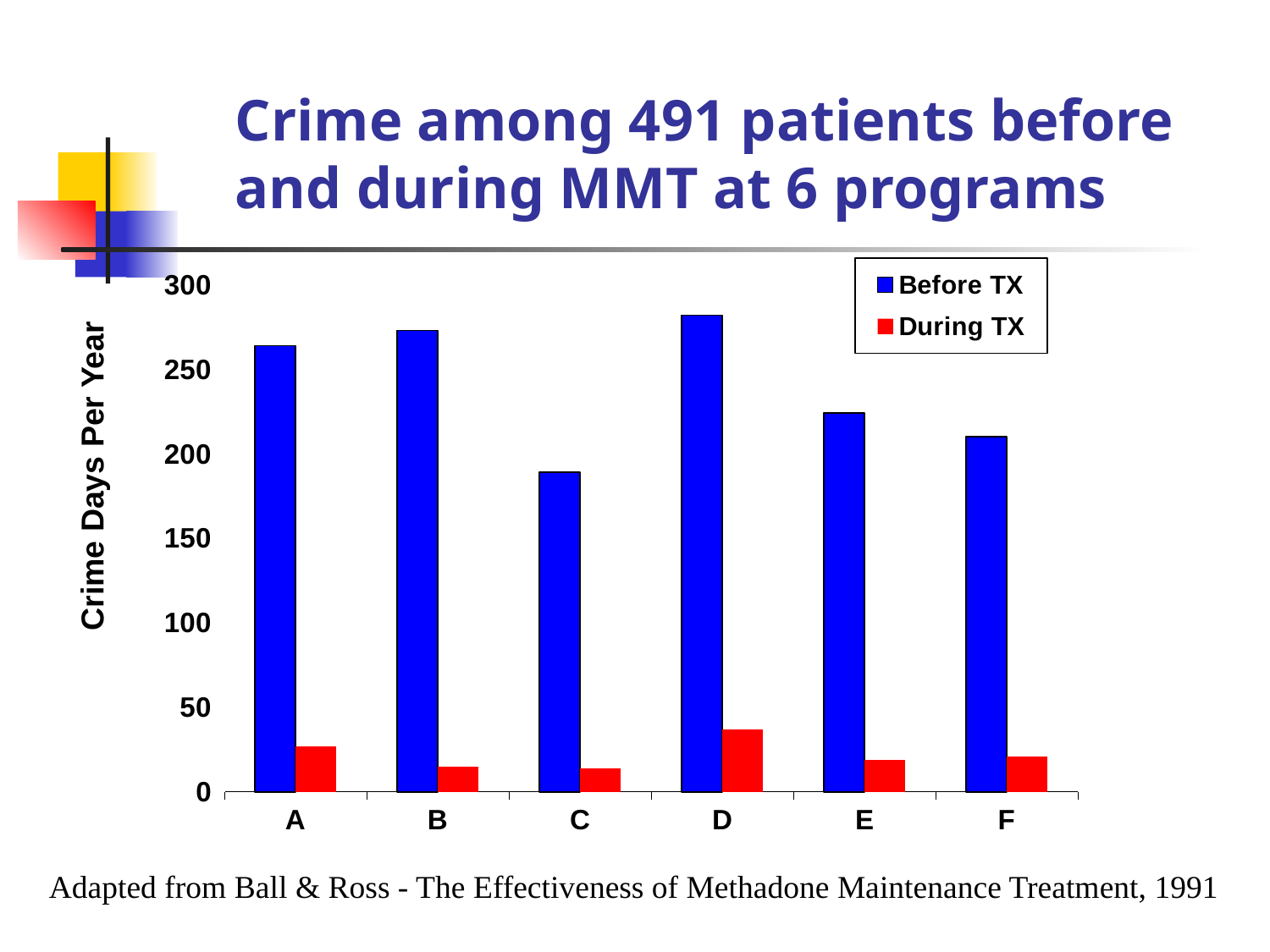
How many series does the legend list? 2 Which is larger, the During TX value for program D or for program B? D How many programs (categories) are shown on the x axis? 6 What kind of chart is shown on the slide? bar chart What is the label of the y axis? Crime Days Per Year Is the Before TX value for program A greater or less than 250? greater Is the During TX value for program D greater or less than 50? less Which program has the highest During TX value? D Is the Before TX value for program C greater or less than 200? less Which program has the lowest Before TX value? C Which is larger, the Before TX value for program E or for program F? E Which program has the highest Before TX value? D